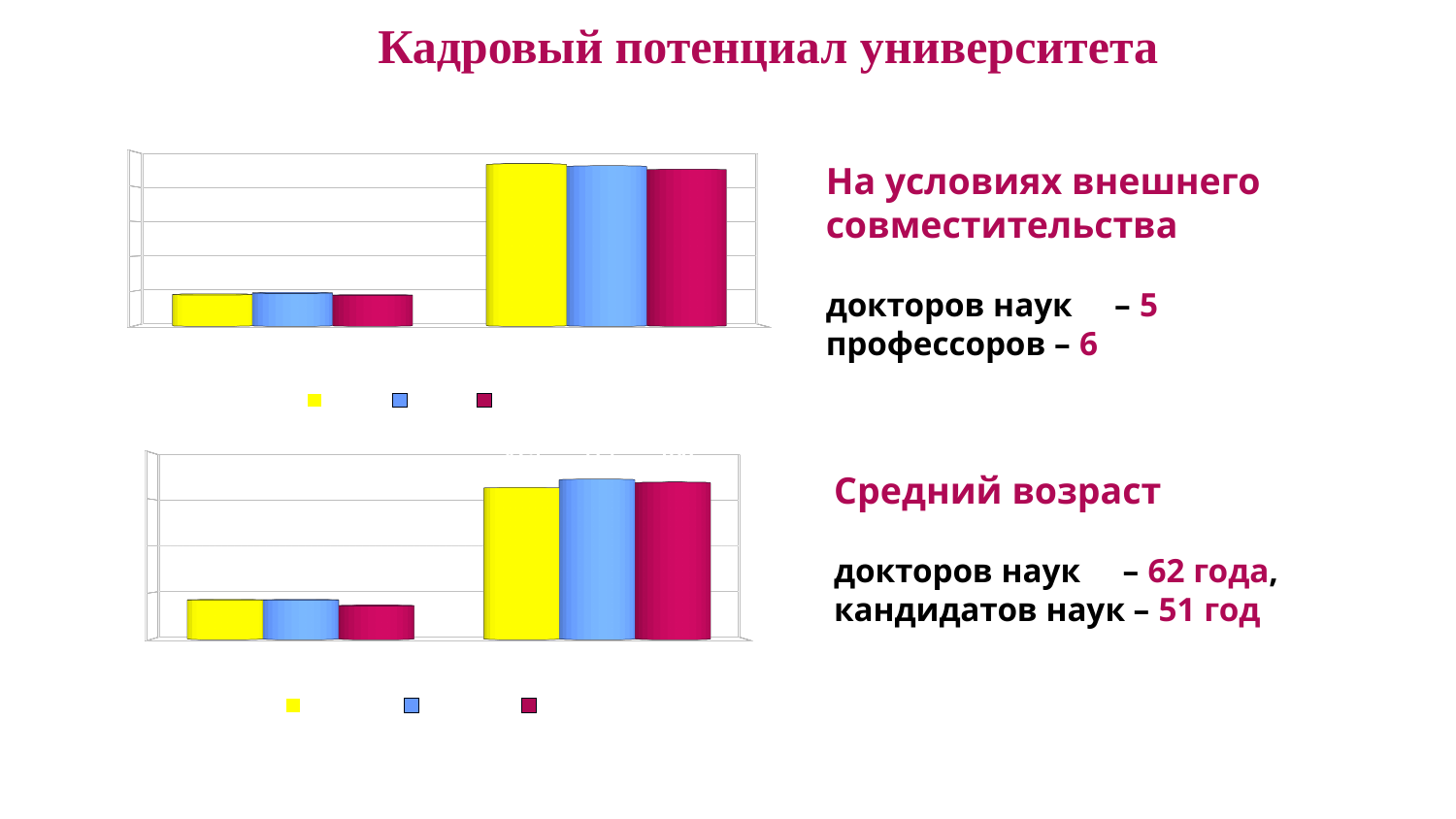
What kind of chart is the bottom chart on the slide? bar chart How many groups of bars are plotted in the top chart? 2 In the bottom chart, which group of bars is taller, the left group or the right group? the right group How many series does the legend of the top chart list? 3 In the top chart, which group of bars is taller, the left group or the right group? the right group How many series does the legend of the bottom chart list? 3 What colours are the three series in the top chart? yellow, blue and red How many groups of bars are plotted in the bottom chart? 2 How many charts are shown on the slide? 2 What kind of chart is the top chart on the slide? bar chart